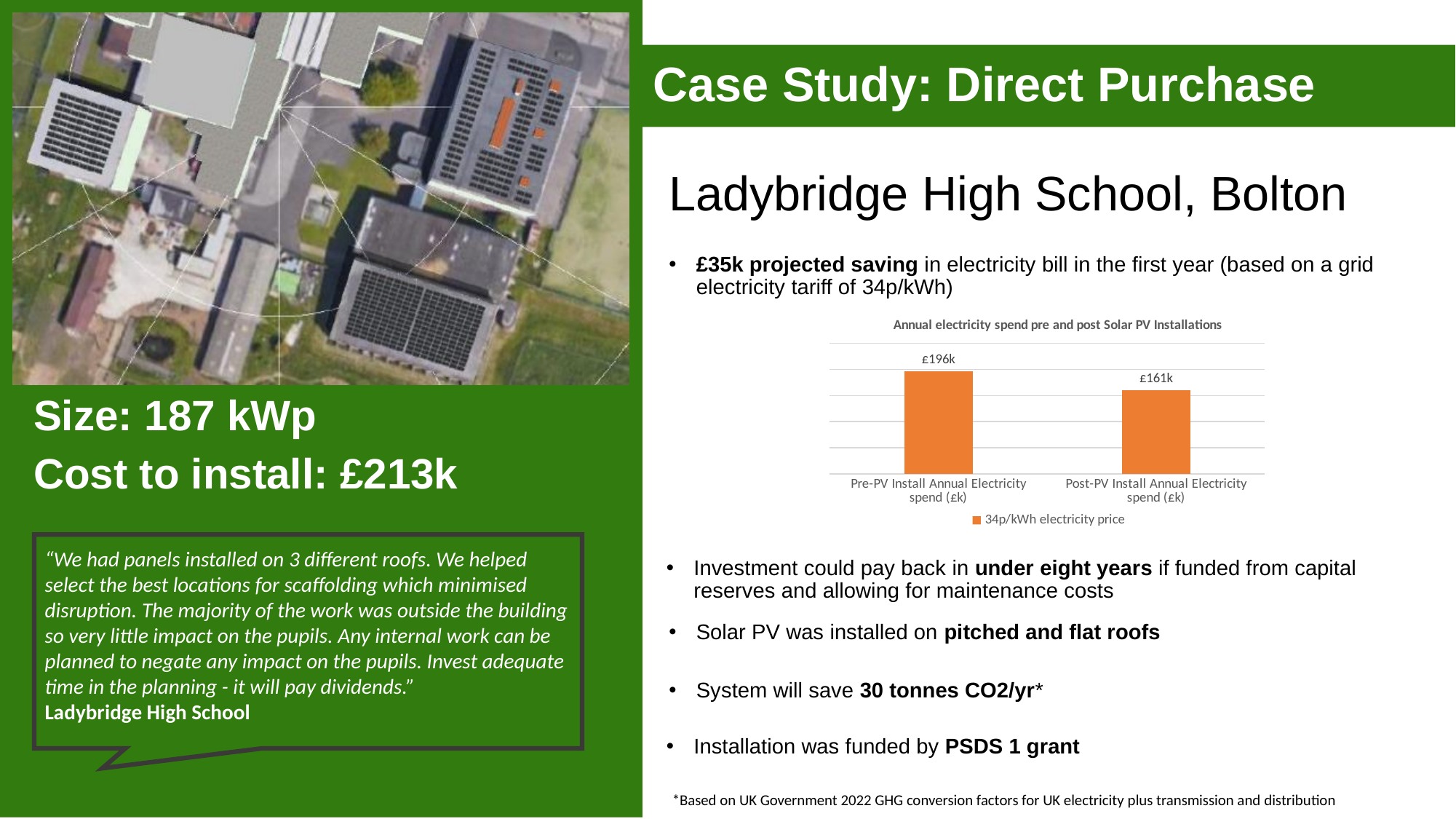
Is the Pre-PV Install annual electricity spend larger or smaller than the Post-PV Install spend? larger What is the legend entry shown on the chart? 34p/kWh electricity price What is the Post-PV Install Annual Electricity spend (£k) shown on the chart? £161k What is the Pre-PV Install Annual Electricity spend (£k) shown on the chart? £196k Which category has the higher annual electricity spend on the chart? Pre-PV Install Annual Electricity spend (£k) Do the values on the chart rise or fall from the Pre-PV bar to the Post-PV bar? fall What type of chart is shown on the slide? bar chart Which category has the lower annual electricity spend on the chart? Post-PV Install Annual Electricity spend (£k) How many series does the chart legend list? 1 What is the difference between the Pre-PV and Post-PV annual electricity spend on the chart? £35k What is the title of the chart? Annual electricity spend pre and post Solar PV Installations How many bars are plotted on the chart? 2